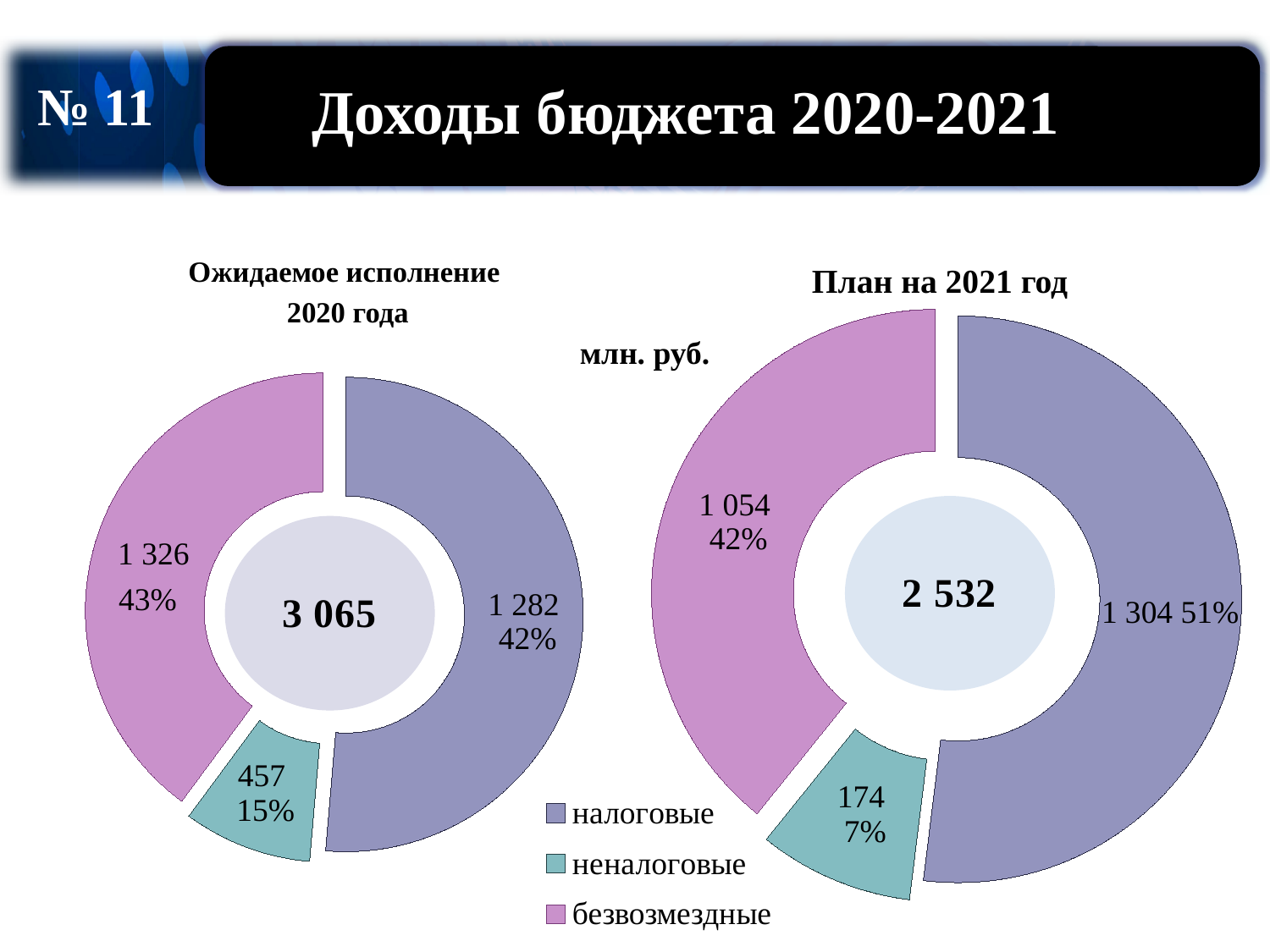
In the chart titled 'План на 2021 год', what share of the total do безвозмездные make up? 42% In the chart titled 'Ожидаемое исполнение 2020 года', what share of the total do неналоговые make up? 15% In the chart titled 'Ожидаемое исполнение 2020 года', what is the value for налоговые? 1 282 Is the value for неналоговые larger in the chart titled 'Ожидаемое исполнение 2020 года' or in the chart titled 'План на 2021 год'? Ожидаемое исполнение 2020 года In the chart titled 'Ожидаемое исполнение 2020 года', what is the difference between безвозмездные and неналоговые? 869 What type of chart is the chart titled 'Ожидаемое исполнение 2020 года'? doughnut chart How many categories does the legend list for the charts on the slide? 3 In the chart titled 'Ожидаемое исполнение 2020 года', which category has the smallest value? неналоговые In the chart titled 'План на 2021 год', what is the difference between налоговые and безвозмездные? 250 In the chart titled 'План на 2021 год', which category has the largest value? налоговые What total is shown in the centre of the chart titled 'План на 2021 год'? 2 532 In the chart titled 'План на 2021 год', what is the value for неналоговые? 174